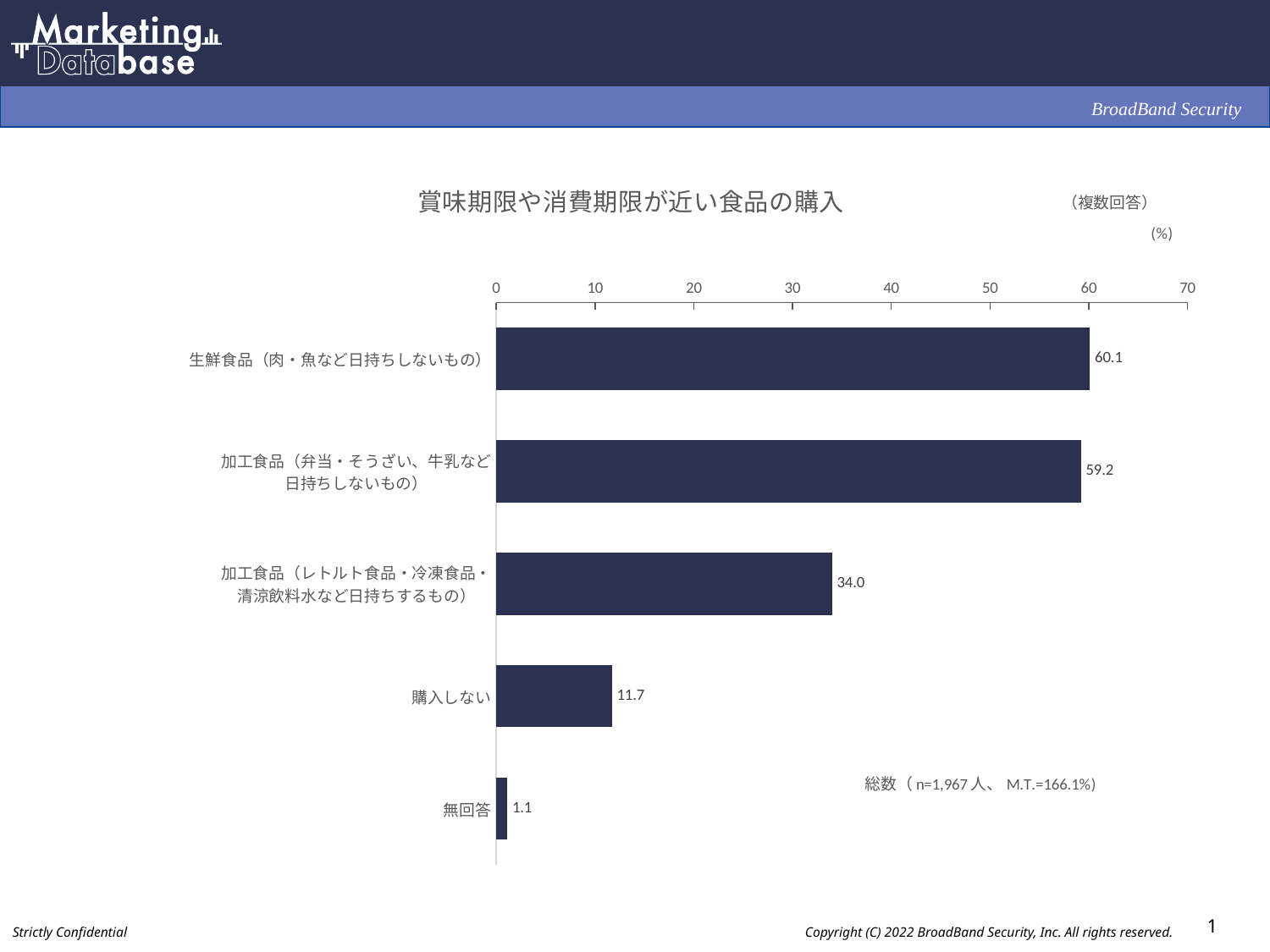
How many categories are shown in the chart? 5 What is the title of the chart? 賞味期限や消費期限が近い食品の購入 Which is larger, the value for 加工食品（レトルト食品・冷凍食品・清涼飲料水など日持ちするもの） or the value for 購入しない? 加工食品（レトルト食品・冷凍食品・清涼飲料水など日持ちするもの） What kind of chart is shown on the slide? bar chart What is the difference between the values for 加工食品（レトルト食品・冷凍食品・清涼飲料水など日持ちするもの） and 購入しない? 22.3 What is the value for 加工食品（レトルト食品・冷凍食品・清涼飲料水など日持ちするもの）? 34.0 What is the value for 生鮮食品（肉・魚など日持ちしないもの）? 60.1 Is the value for 加工食品（弁当・そうざい、牛乳など日持ちしないもの） greater or less than 50? greater Which category has the highest value? 生鮮食品（肉・魚など日持ちしないもの） Which category has the lowest value? 無回答 What is the value for 購入しない? 11.7 What is the difference between the values for 生鮮食品（肉・魚など日持ちしないもの） and 加工食品（弁当・そうざい、牛乳など日持ちしないもの）? 0.9